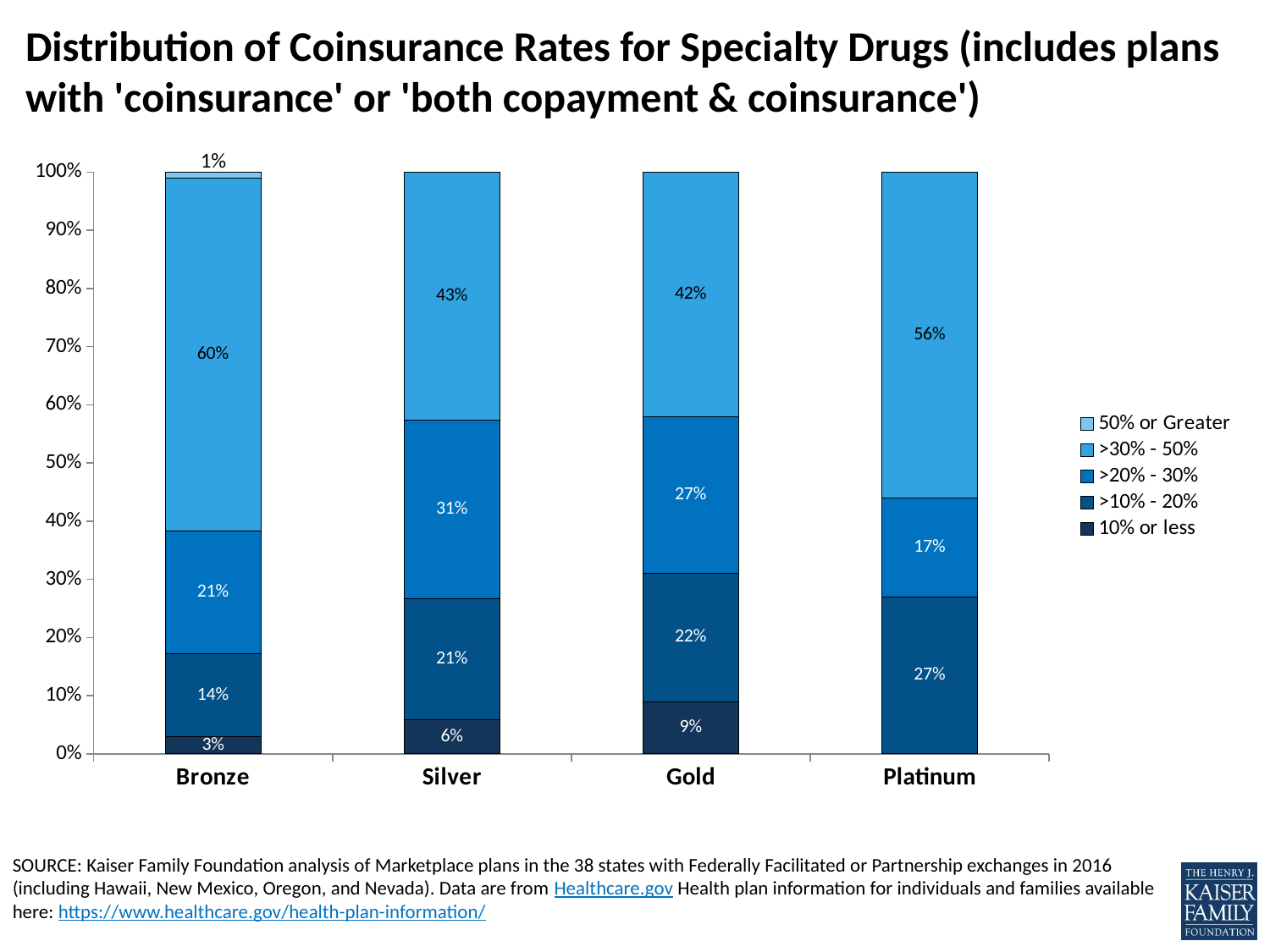
What kind of chart is shown on the slide? Stacked bar chart What share of Gold plans have a coinsurance rate of >20% - 30%? 27% What share of Platinum plans have a coinsurance rate of >30% - 50%? 56% What is the difference between the >30% - 50% share for Bronze and for Platinum? 4% What share of Bronze plans have a coinsurance rate of >30% - 50%? 60% Among Bronze, Silver and Gold, which plan type has the smallest share in the 10% or less category? Bronze What share of Bronze plans have a coinsurance rate of 50% or Greater? 1% How many series does the legend list? 5 What share of Silver plans have a coinsurance rate of 10% or less? 6% Which is larger, the >20% - 30% share for Silver or for Gold? Silver How many plan categories are shown on the x axis? 4 Which plan type has the largest share in the >30% - 50% category? Bronze